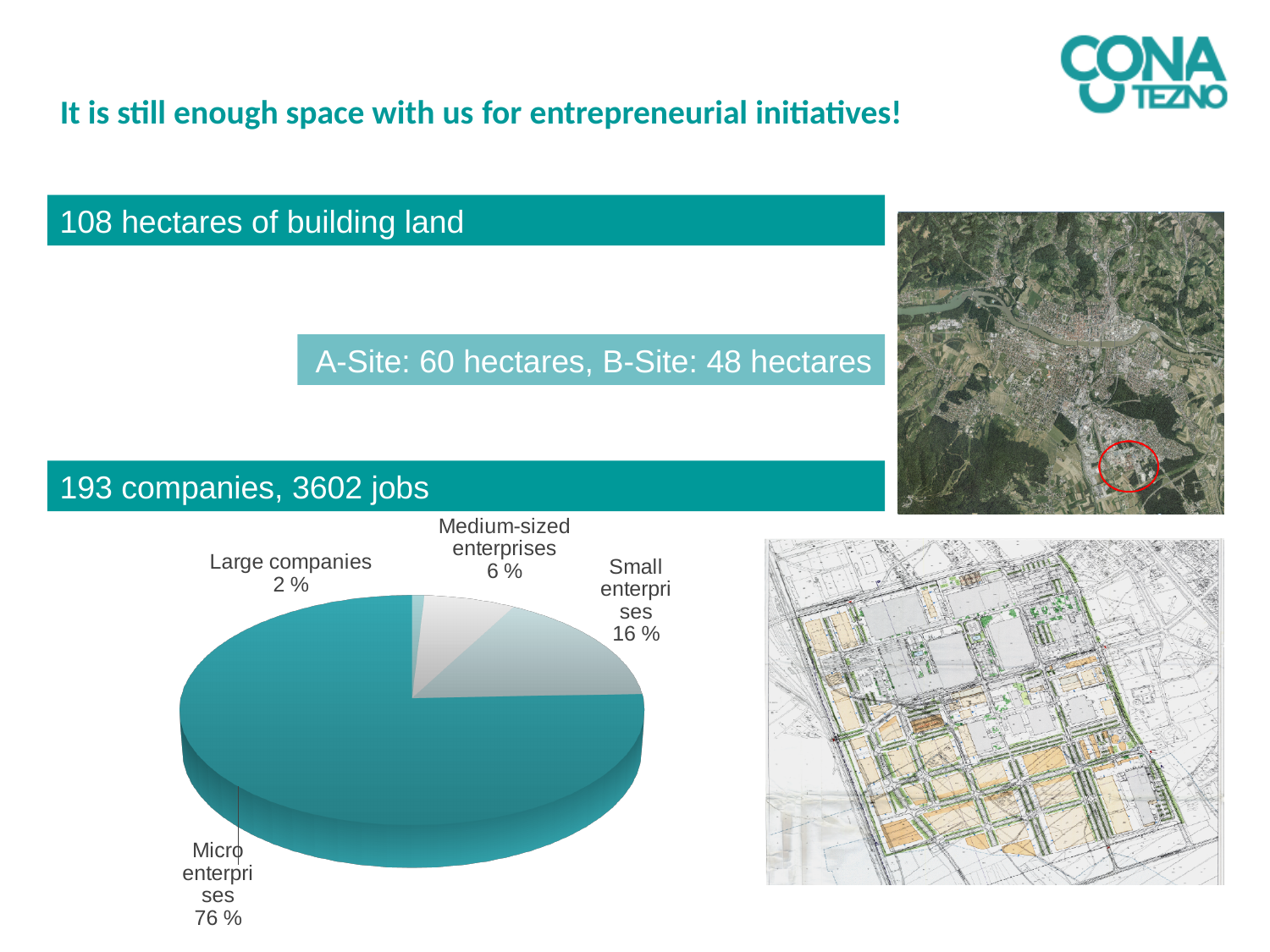
Which category has the largest slice in the pie chart? Micro enterprises What percentage of the pie chart is labelled for small enterprises? 16 % What value is shown for large companies in the pie chart? 2 % How many categories are shown in the pie chart? 4 Which category has the smallest slice in the pie chart? Large companies What is the difference in percentage points between the medium-sized enterprises slice and the large companies slice? 4 What type of chart is shown on the slide? Pie chart Which slice is larger in the pie chart: small enterprises or medium-sized enterprises? Small enterprises What colour is the micro enterprises slice in the pie chart? Teal What is the difference in percentage points between the micro enterprises slice and the small enterprises slice? 60 What share of the pie chart do micro enterprises account for? 76 % What value is shown for medium-sized enterprises in the pie chart? 6 %